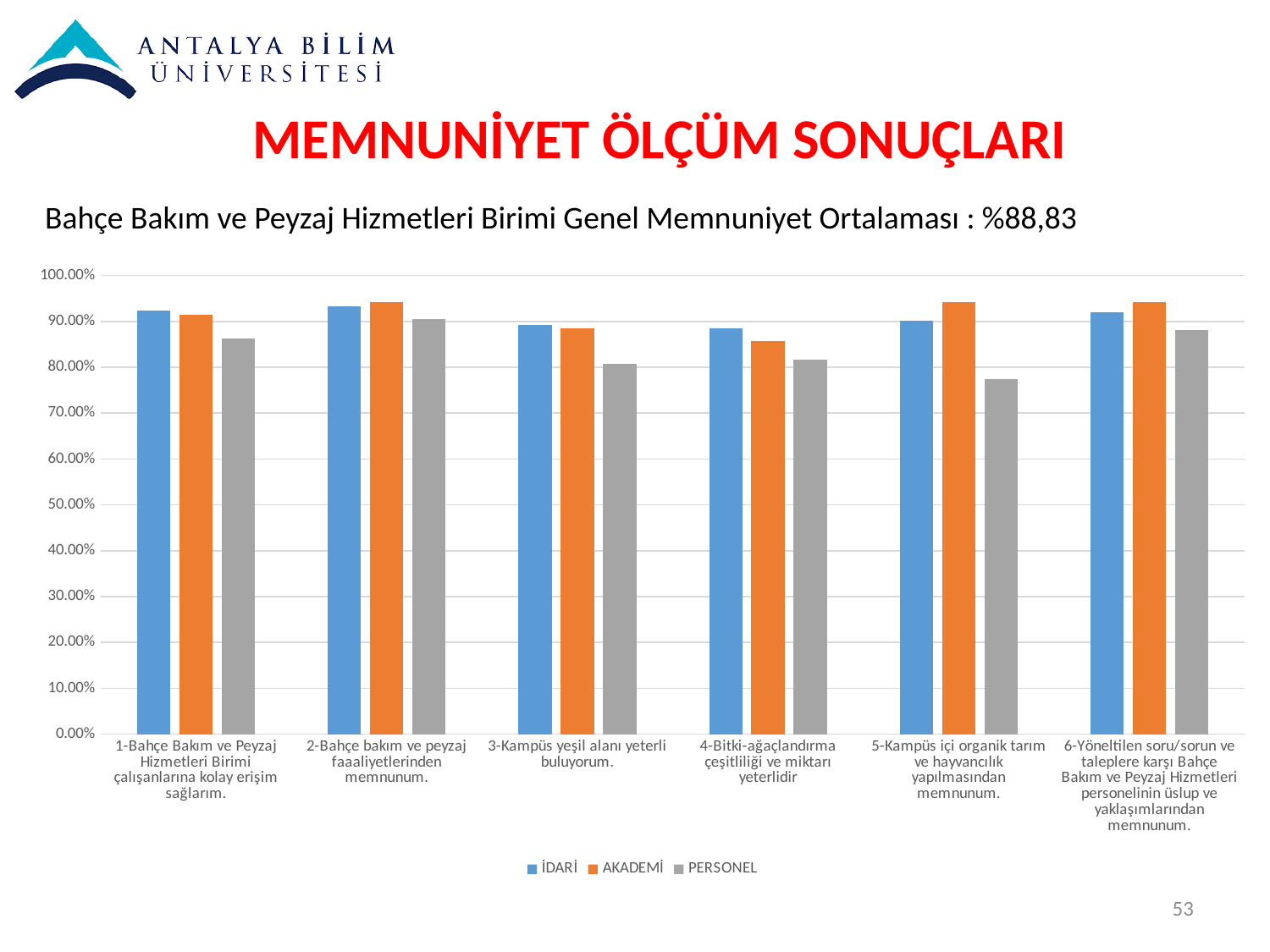
Is the AKADEMİ value for category 2 (Bahçe bakım ve peyzaj faaaliyetlerinden memnunum.) greater or less than 90%? greater How many categories (questions) are shown on the x axis? 6 Which series has the lowest bar in every category? PERSONEL What kind of chart is shown on the slide? bar chart Is the PERSONEL value for category 1 (Bahçe Bakım ve Peyzaj Hizmetleri Birimi çalışanlarına kolay erişim sağlarım.) greater or less than 90%? less Which series are listed in the legend? İDARİ, AKADEMİ, PERSONEL Is the AKADEMİ value for category 4 (Bitki-ağaçlandırma çeşitliliği ve miktarı yeterlidir) greater or less than 90%? less How many series does the legend list? 3 For category 5 (Kampüs içi organik tarım ve hayvancılık yapılmasından memnunum.), which is larger: the İDARİ value or the PERSONEL value? İDARİ For category 5 (Kampüs içi organik tarım ve hayvancılık yapılmasından memnunum.), which is larger: the AKADEMİ value or the İDARİ value? AKADEMİ For which category is the PERSONEL value the lowest? 5-Kampüs içi organik tarım ve hayvancılık yapılmasından memnunum.